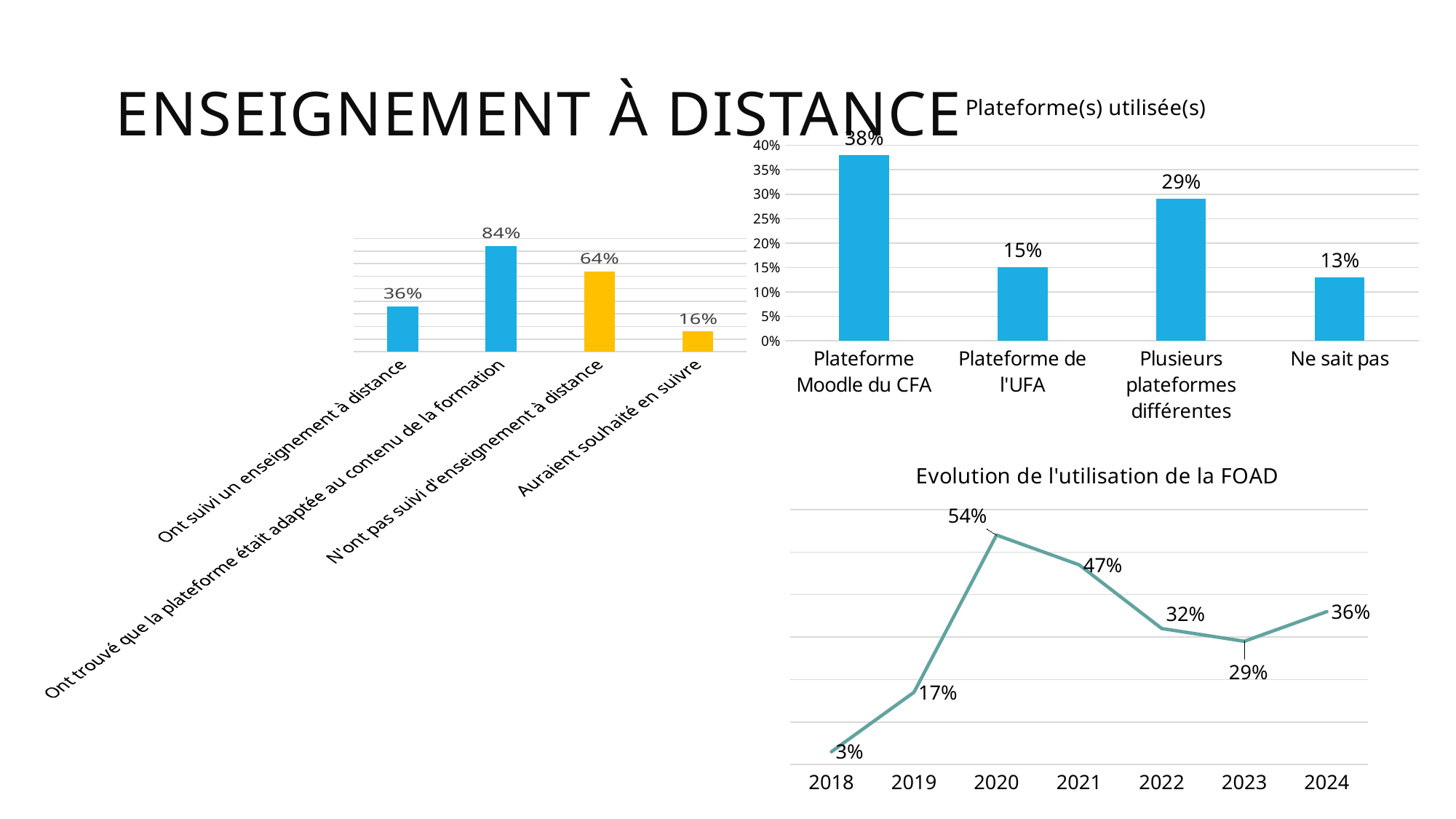
In the 'Evolution de l'utilisation de la FOAD' chart, what is the difference between 2024 and 2023? 7% In the 'Evolution de l'utilisation de la FOAD' chart, do the values rise or fall from 2020 to 2023? fall In the bar chart on the left of the slide, what is the value for 'Auraient souhaité en suivre'? 16% In the 'Plateforme(s) utilisée(s)' chart, how many categories are shown? 4 In the 'Plateforme(s) utilisée(s)' chart, what is the difference between 'Plusieurs plateformes différentes' and 'Plateforme de l'UFA'? 14% In the bar chart on the left of the slide, what is the value for 'Ont trouvé que la plateforme était adaptée au contenu de la formation'? 84% What kind of chart is 'Evolution de l'utilisation de la FOAD'? line chart In the 'Evolution de l'utilisation de la FOAD' chart, which year has the lowest value? 2018 In the 'Plateforme(s) utilisée(s)' chart, which category has the lowest value? Ne sait pas In the 'Plateforme(s) utilisée(s)' chart, what is the value for 'Plateforme Moodle du CFA'? 38% In the 'Evolution de l'utilisation de la FOAD' chart, what is the value for 2020? 54% In the bar chart on the left of the slide, which is larger: 'Ont suivi un enseignement à distance' or 'N'ont pas suivi d'enseignement à distance'? N'ont pas suivi d'enseignement à distance